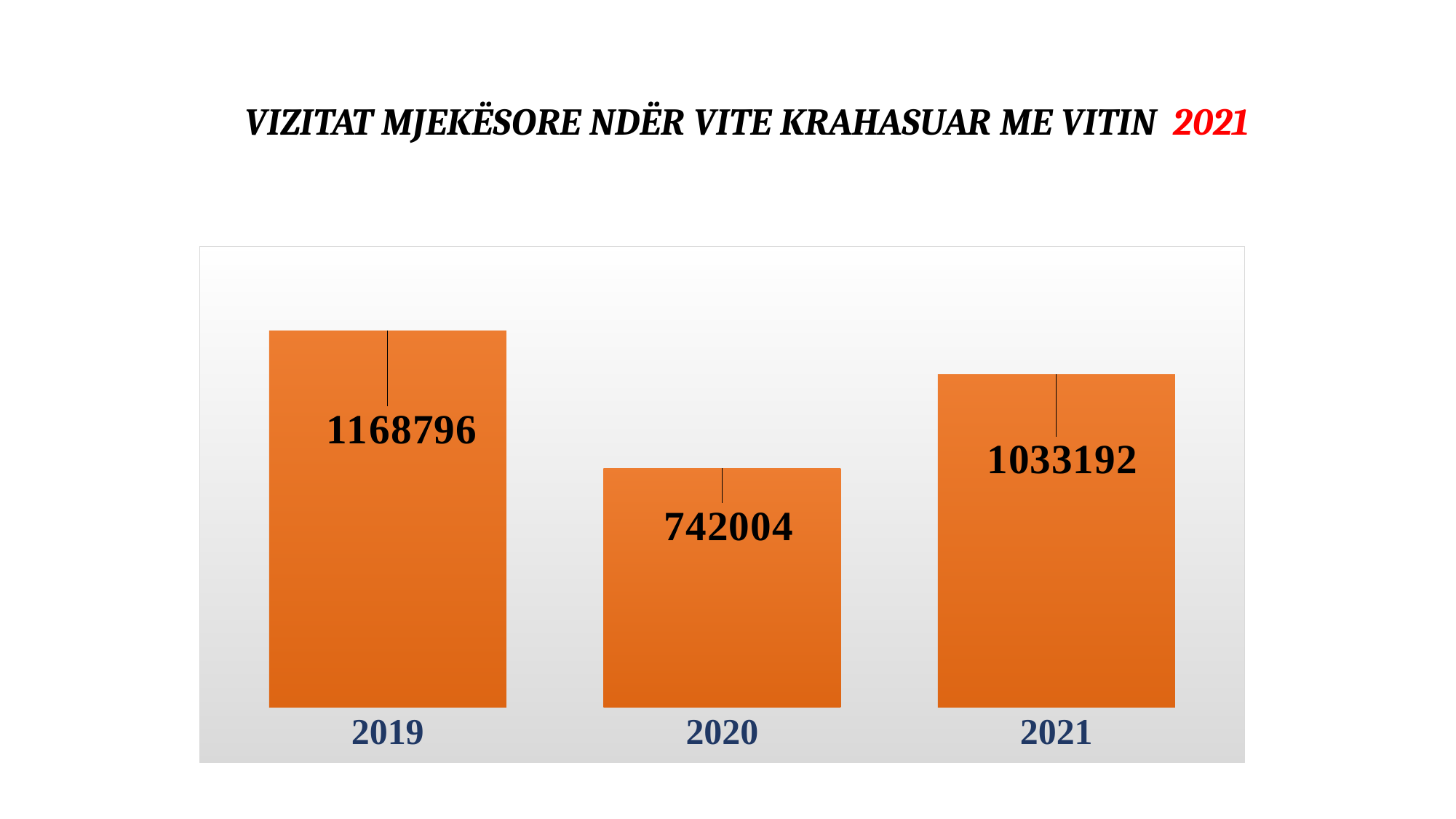
Which year has the highest value? 2019 What is the difference between the values for 2021 and 2020? 291188 Which is larger, the value for 2021 or the value for 2020? 2021 What is the value for 2020? 742004 What colour are the bars in the chart? orange What is the value for 2019? 1168796 How many years are shown on the chart? 3 What kind of chart is shown on the slide? bar chart What is the difference between the values for 2019 and 2021? 135604 What is the difference between the values for 2019 and 2020? 426792 Which year has the lowest value? 2020 What is the value for 2021? 1033192